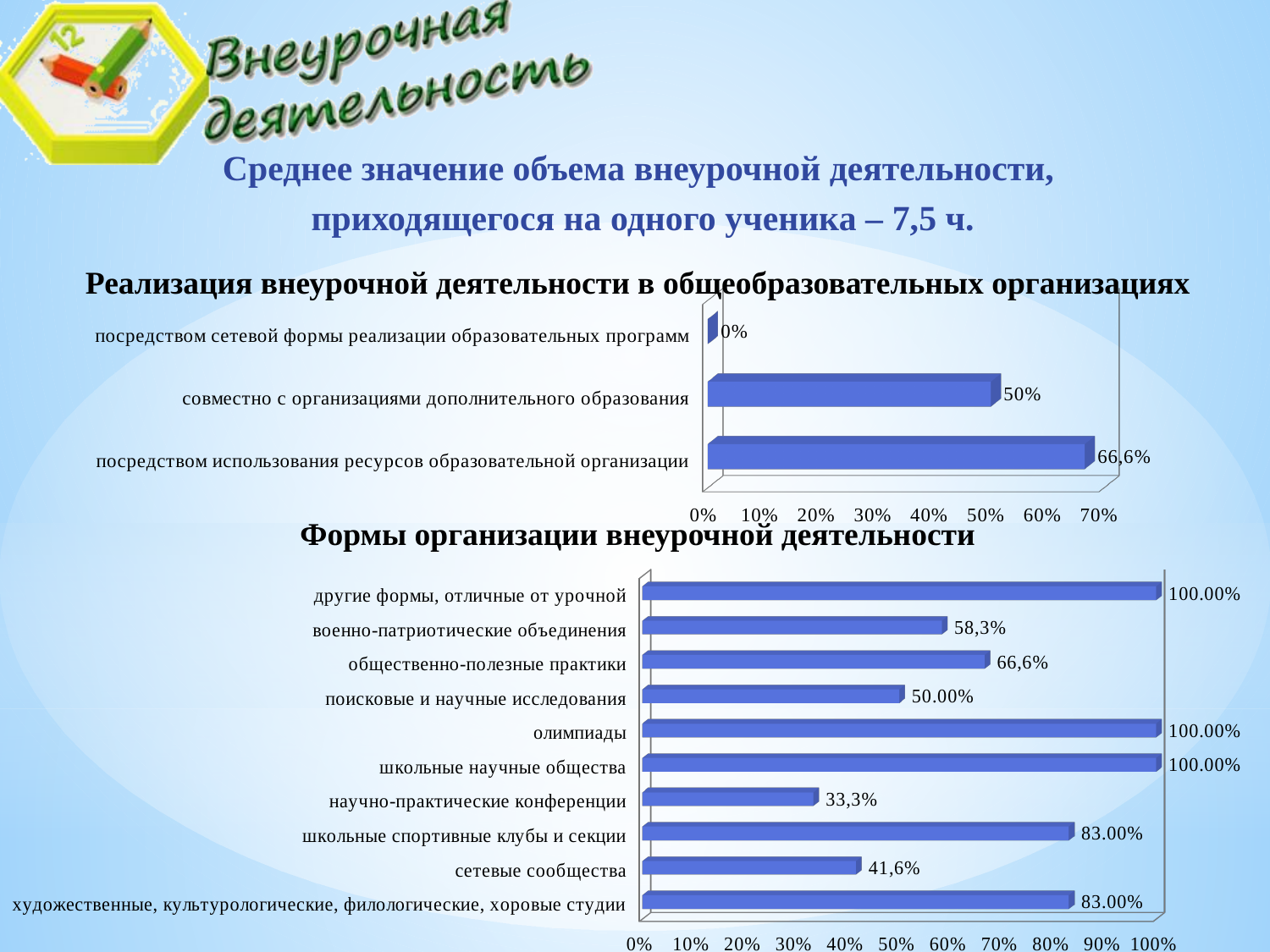
In the chart 'Формы организации внеурочной деятельности', which is larger: 'военно-патриотические объединения' or 'общественно-полезные практики'? общественно-полезные практики In the chart 'Формы организации внеурочной деятельности', what is the difference between 'школьные спортивные клубы и секции' and 'поисковые и научные исследования'? 33.00% In the chart 'Формы организации внеурочной деятельности', which category has the lowest value? научно-практические конференции In the chart 'Формы организации внеурочной деятельности', how many categories have a value of 100.00%? 3 In the chart 'Реализация внеурочной деятельности в общеобразовательных организациях', what is the value for 'совместно с организациями дополнительного образования'? 50% In the chart 'Реализация внеурочной деятельности в общеобразовательных организациях', which category has the highest value? посредством использования ресурсов образовательной организации What type of chart is 'Формы организации внеурочной деятельности'? bar chart How many categories are shown in the chart 'Формы организации внеурочной деятельности'? 10 How many categories are shown in the chart 'Реализация внеурочной деятельности в общеобразовательных организациях'? 3 In the chart 'Реализация внеурочной деятельности в общеобразовательных организациях', what is the value for 'посредством сетевой формы реализации образовательных программ'? 0% In the chart 'Формы организации внеурочной деятельности', what is the value for 'научно-практические конференции'? 33,3% In the chart 'Формы организации внеурочной деятельности', what is the value for 'сетевые сообщества'? 41,6%